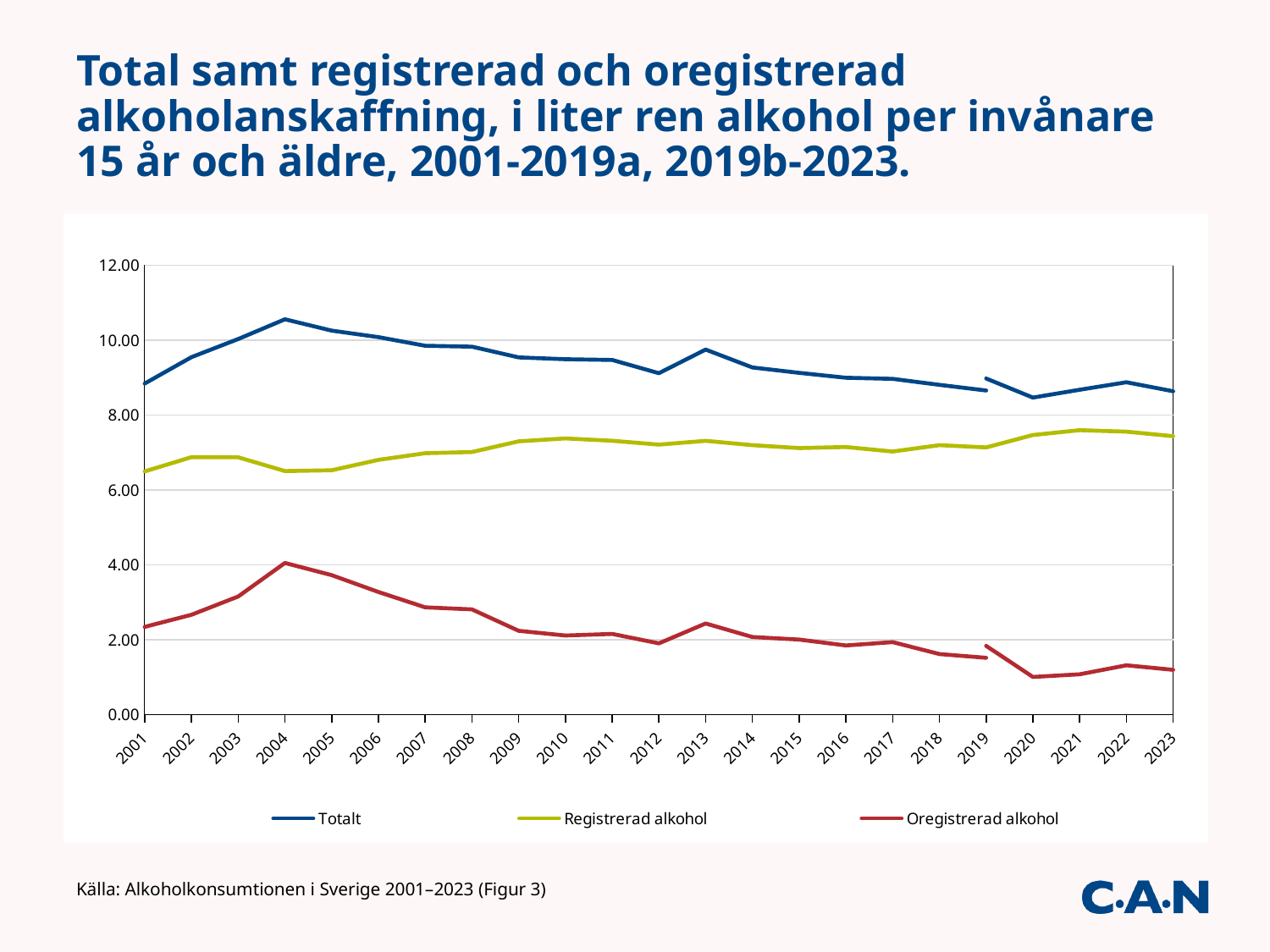
In which year does the Totalt series reach its highest value? 2004 How many series does the legend list? 3 How many years are shown on the x axis? 23 Which colour is used for the Totalt series? dark blue Is the value for Oregistrerad alkohol in 2020 greater or less than 2.00? less Is the value for Totalt in 2004 greater or less than 10.00? greater Does the Oregistrerad alkohol series generally rise or fall from 2004 to 2023? fall In which year does the Oregistrerad alkohol series reach its highest value? 2004 Is the value for Registrerad alkohol in 2021 greater or less than 8.00? less In which year does the Oregistrerad alkohol series reach its lowest value? 2020 Which series has the higher value in 2023, Registrerad alkohol or Oregistrerad alkohol? Registrerad alkohol What kind of chart is shown on the slide? line chart